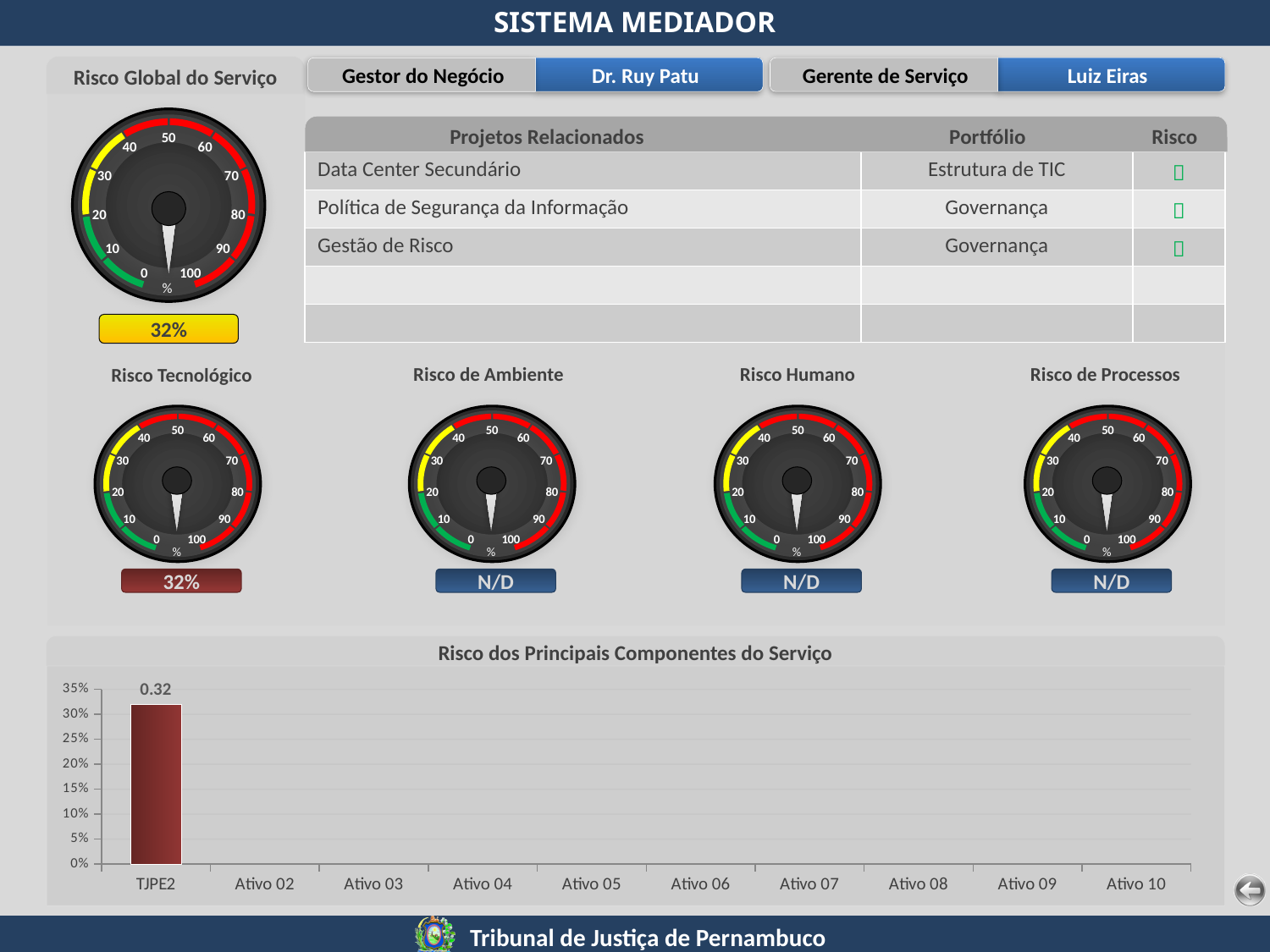
What is the highest tick shown on the y axis of the chart 'Risco dos Principais Componentes do Serviço'? 35% What kind of chart is 'Risco dos Principais Componentes do Serviço'? bar chart How many categories are listed along the x axis of the chart 'Risco dos Principais Componentes do Serviço'? 10 In the chart 'Risco dos Principais Componentes do Serviço', what value is labelled on the bar for TJPE2? 0.32 In the chart 'Risco dos Principais Componentes do Serviço', is the value for TJPE2 greater or less than 35%? less In the chart 'Risco dos Principais Componentes do Serviço', what is the label of the last category on the x axis? Ativo 10 In the chart 'Risco dos Principais Componentes do Serviço', how many categories actually have a bar plotted? 1 What is the title of the bar chart at the bottom of the slide? Risco dos Principais Componentes do Serviço In the chart 'Risco dos Principais Componentes do Serviço', is the value for TJPE2 greater or less than 30%? greater Which category has the highest value in the chart 'Risco dos Principais Componentes do Serviço'? TJPE2 In the chart 'Risco dos Principais Componentes do Serviço', what is the label of the first category on the x axis? TJPE2